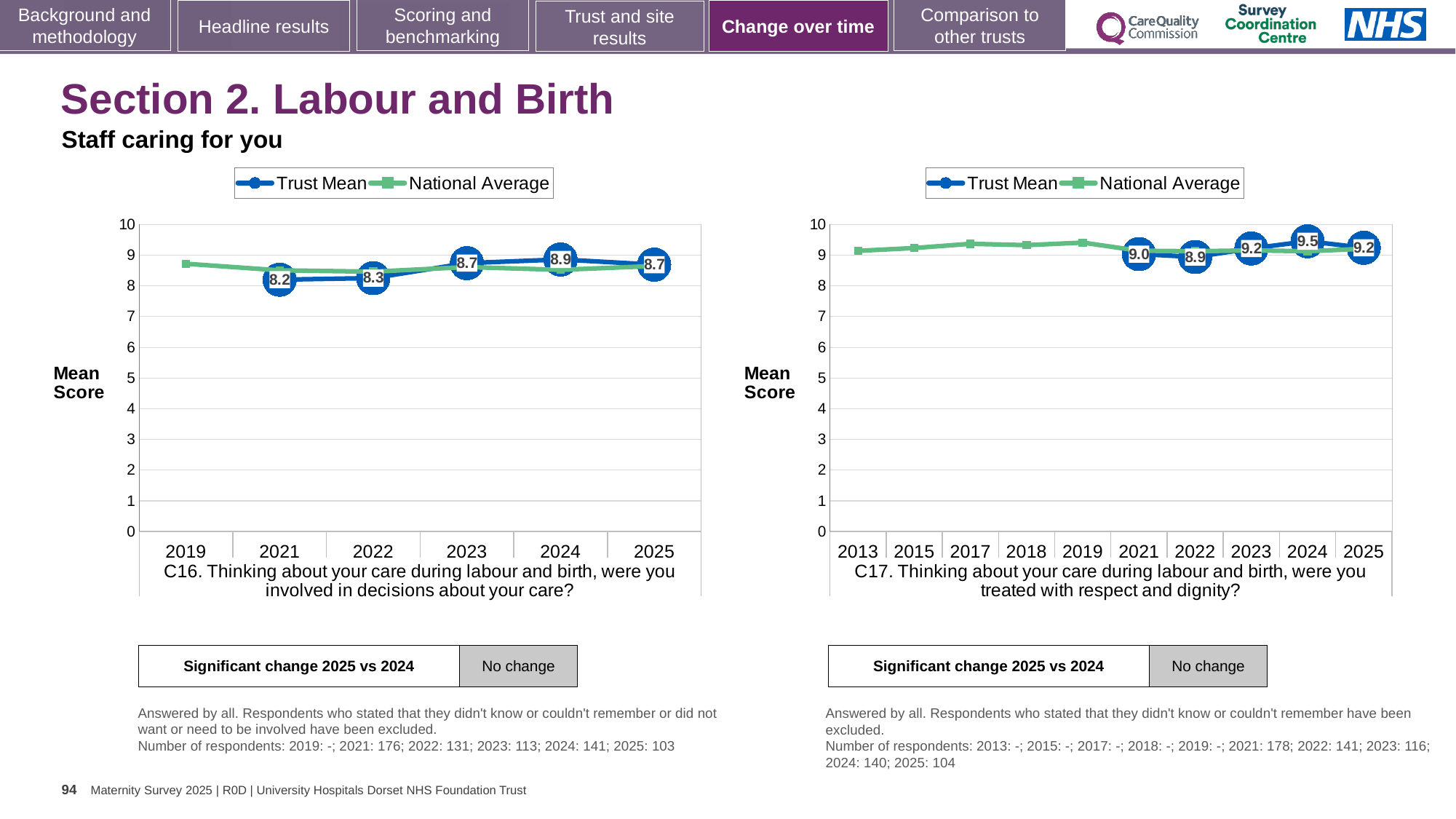
How many series does the legend of the C16 chart (left) list? 2 In the C16 chart (left), what is the Trust Mean for 2024? 8.9 In the C17 chart (right), how many years are shown on the x axis? 10 In the C17 chart (right), which year has the lowest Trust Mean? 2022 In the C16 chart (left), which year has the highest Trust Mean? 2024 In the C16 chart (left), what is the Trust Mean for 2021? 8.2 In the C17 chart (right), what is the Trust Mean for 2024? 9.5 In the C17 chart (right), which is larger: the Trust Mean for 2024 or the Trust Mean for 2025? 2024 In the C16 chart (left), what is the difference between the Trust Mean for 2024 and the Trust Mean for 2021? 0.7 In the C17 chart (right), what is the Trust Mean for 2022? 8.9 In the C16 chart (left), is the National Average for 2019 greater or less than 8? greater What kind of chart is the C17 chart (right)? Line chart